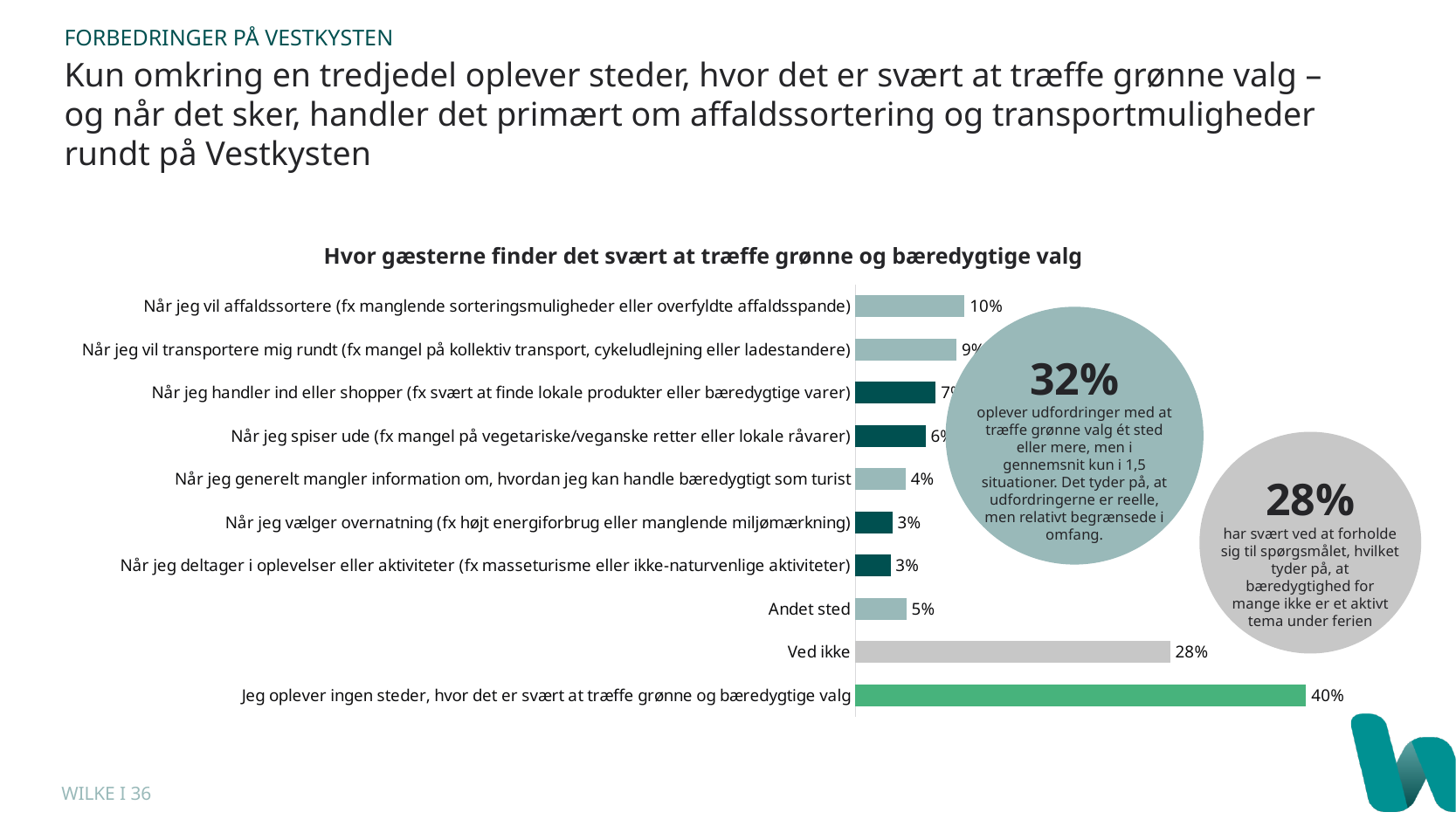
What percentage is shown for "Jeg oplever ingen steder, hvor det er svært at træffe grønne og bæredygtige valg"? 40% What is the difference between the value for "Jeg oplever ingen steder, hvor det er svært at træffe grønne og bæredygtige valg" and the value for "Ved ikke"? 12 percentage points What is the title of the chart? Hvor gæsterne finder det svært at træffe grønne og bæredygtige valg What percentage is shown for "Når jeg generelt mangler information om, hvordan jeg kan handle bæredygtigt som turist"? 4% What percentage is shown for "Ved ikke"? 28% What percentage is shown for "Andet sted"? 5% How many categories (bars) does the chart show? 10 Which category has the highest value in the chart? Jeg oplever ingen steder, hvor det er svært at træffe grønne og bæredygtige valg What type of chart is shown on the slide? Bar chart Which is larger: the value for "Når jeg vil affaldssortere" or the value for "Andet sted"? Når jeg vil affaldssortere What percentage is shown for "Når jeg vælger overnatning (fx højt energiforbrug eller manglende miljømærkning)"? 3% What percentage is shown for "Når jeg vil affaldssortere (fx manglende sorteringsmuligheder eller overfyldte affaldsspande)"? 10%